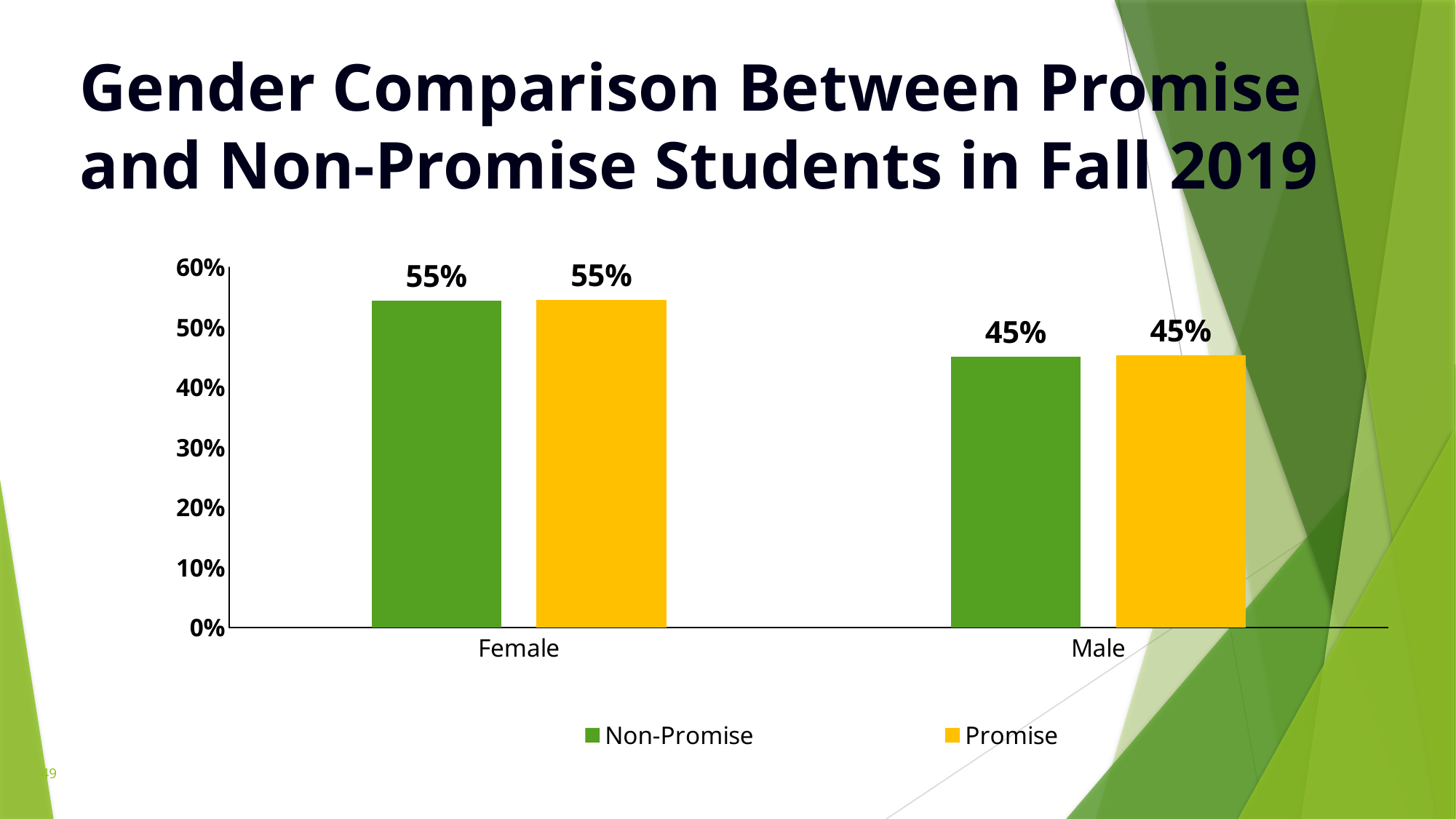
What is the Non-Promise value for Female? 55% What is the Promise value for Male? 45% Is the Promise value for Female larger or smaller than the Promise value for Male? larger Which gender category has the lower Non-Promise value? Male How many gender categories are shown on the x axis? 2 What is the difference between the Non-Promise values for Female and Male? 10% Which gender category has the higher Promise value? Female How many series does the legend list? 2 Which colour represents the Promise series in the legend? yellow What kind of chart is shown on the slide? bar chart What is the Promise value for Female? 55% What is the Non-Promise value for Male? 45%